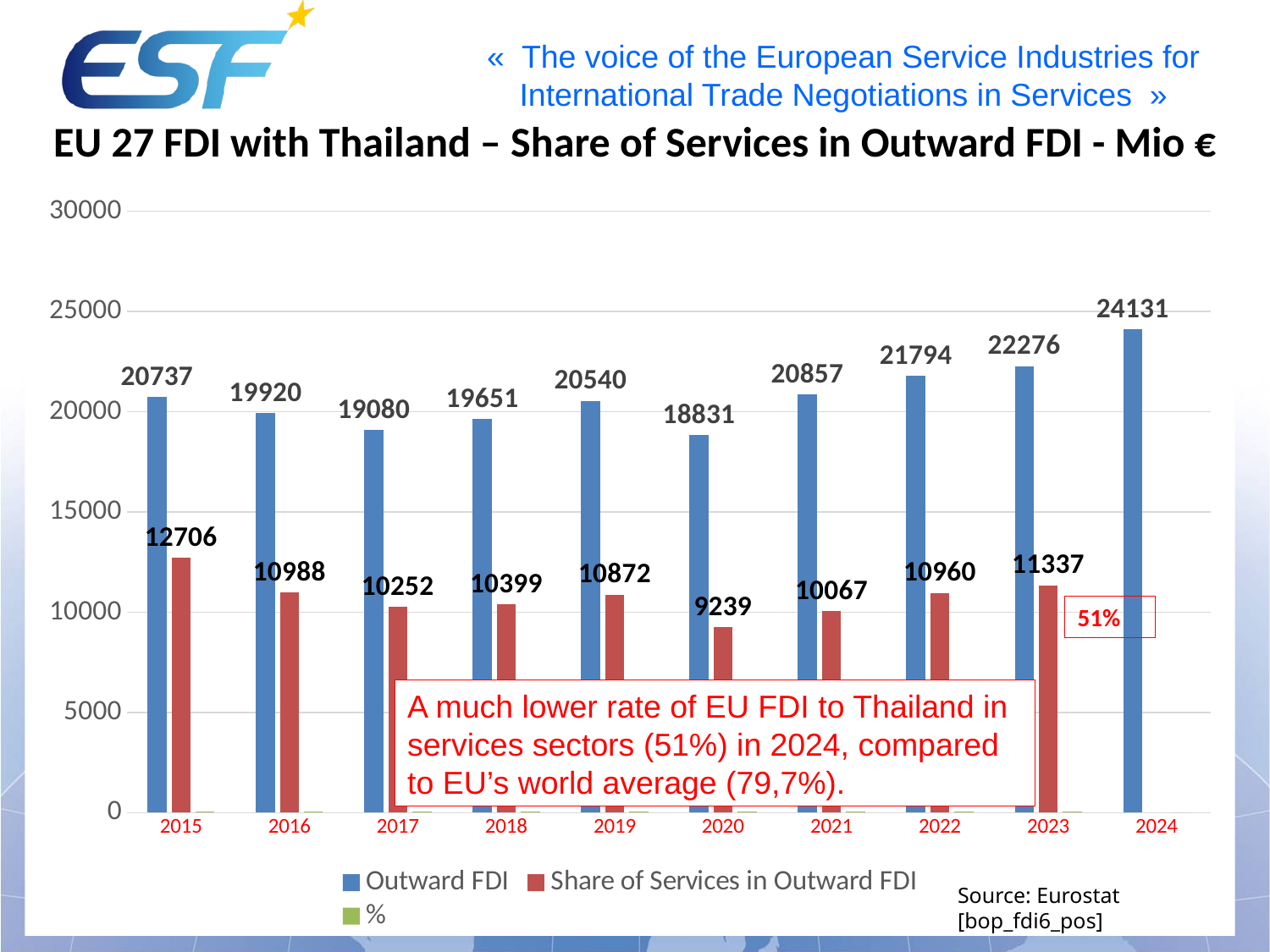
What kind of chart is shown on the slide? Bar chart What is the Share of Services in Outward FDI value for 2020? 9239 In which year is Outward FDI highest? 2024 Which year has the larger Outward FDI, 2015 or 2016? 2015 What is the Share of Services in Outward FDI value for 2015? 12706 What is the difference between Outward FDI and Share of Services in Outward FDI in 2015? 8031 What is the difference between Outward FDI in 2024 and in 2023? 1855 What is the Outward FDI value for 2024? 24131 In which year is Outward FDI lowest? 2020 In which year is the Share of Services in Outward FDI highest? 2015 How many series does the legend list? 3 How many years are shown on the x axis? 10